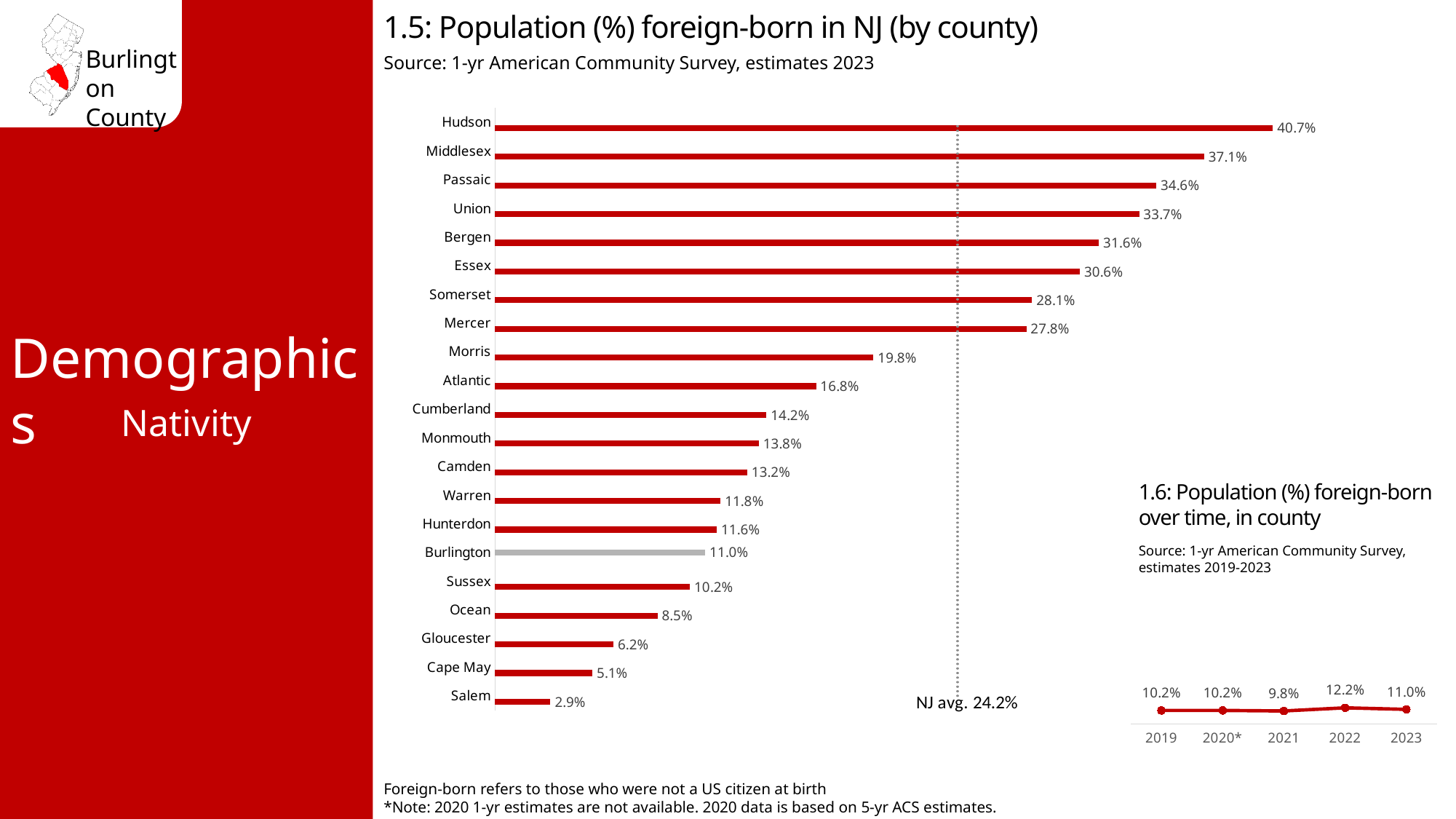
In chart 1.5 (Population (%) foreign-born in NJ by county), what is the NJ average shown by the dotted line? 24.2% In chart 1.6 (Population (%) foreign-born over time, in county), how many years are plotted? 5 In chart 1.5 (Population (%) foreign-born in NJ by county), which county has the lowest value? Salem In chart 1.6 (Population (%) foreign-born over time, in county), what is the value for 2022? 12.2% In chart 1.5 (Population (%) foreign-born in NJ by county), how many counties are shown? 21 In chart 1.5 (Population (%) foreign-born in NJ by county), what is the difference between Hudson and Burlington? 29.7% In chart 1.5 (Population (%) foreign-born in NJ by county), which is larger, Morris or Atlantic? Morris In chart 1.6 (Population (%) foreign-born over time, in county), which year has the lowest value? 2021 What kind of chart is chart 1.5 (Population (%) foreign-born in NJ by county)? Bar chart In chart 1.5 (Population (%) foreign-born in NJ by county), which county has the highest value? Hudson What kind of chart is chart 1.6 (Population (%) foreign-born over time, in county)? Line chart In chart 1.5 (Population (%) foreign-born in NJ by county), what is the value for Burlington? 11.0%